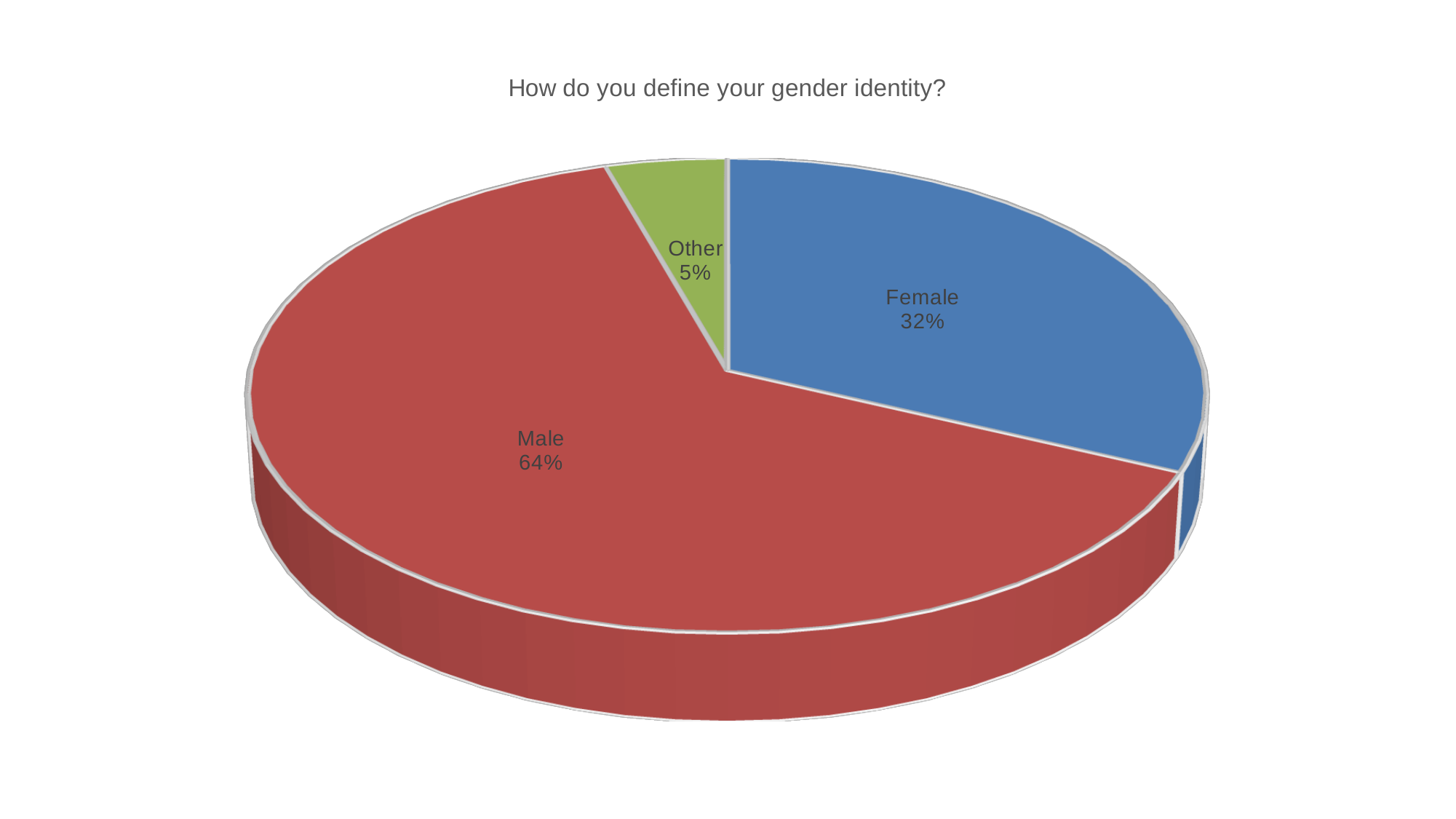
What share of the pie does Female account for? 32% What kind of chart is shown on the slide? Pie chart Which slice is larger, Male or Female? Male Which category has the smallest slice of the pie? Other How many categories are shown in the pie chart? 3 Which category has the largest slice of the pie? Male Which slice is larger, Female or Other? Female What is the difference in percentage points between the Female and Other slices? 27 What is the title of the chart? How do you define your gender identity? What share of the pie does Other account for? 5% What share of the pie does Male account for? 64% What is the difference in percentage points between the Male and Female slices? 32